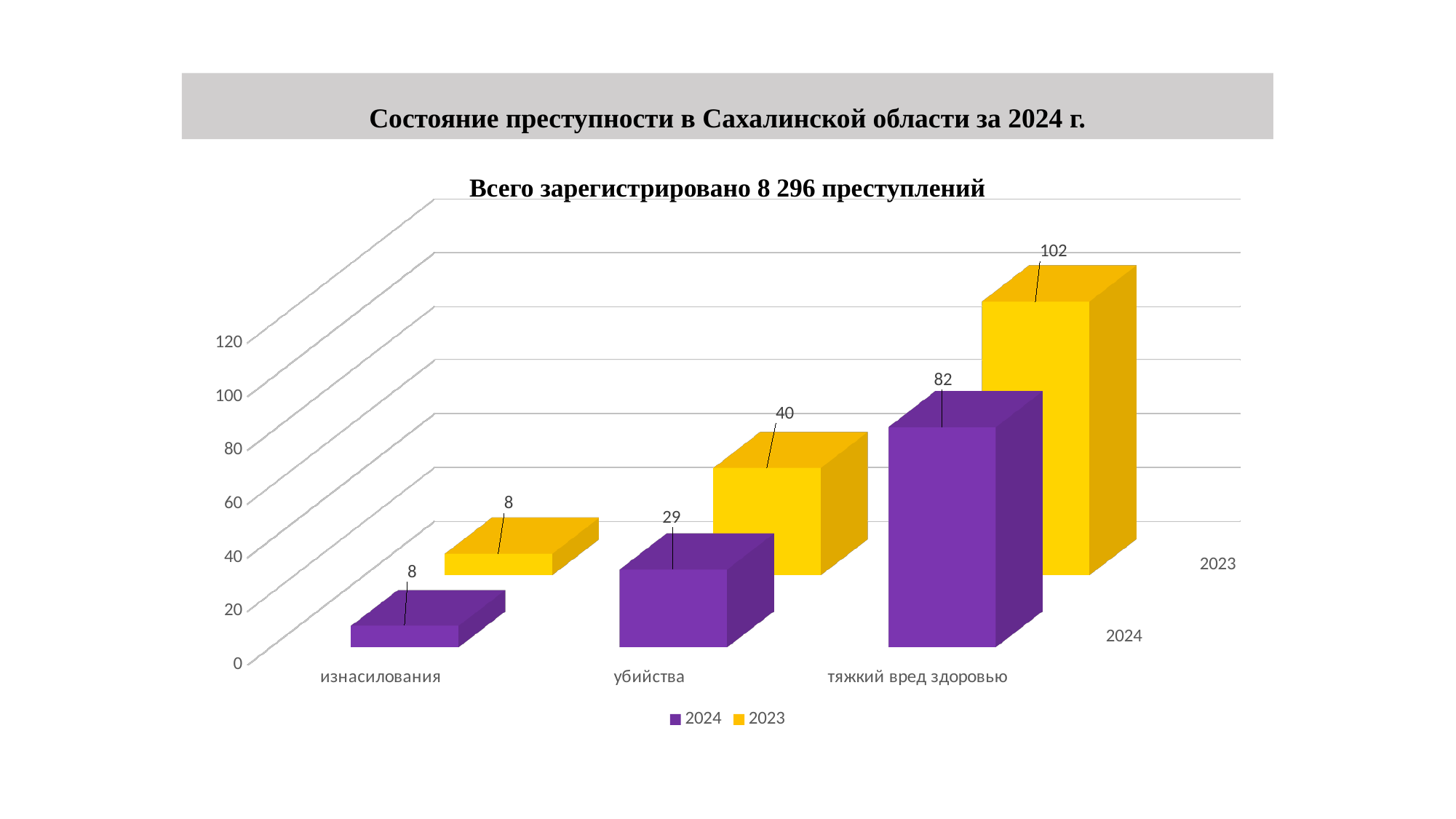
What is the value for тяжкий вред здоровью in the 2024 series? 82 How many categories are shown on the x axis? 3 Which category has the lowest value in the 2024 series? изнасилования How many series does the legend list? 2 What is the value for изнасилования in the 2023 series? 8 What is the value for убийства in the 2024 series? 29 Which category has the highest value in the 2023 series? тяжкий вред здоровью What is the value for тяжкий вред здоровью in the 2023 series? 102 Which is larger for убийства: the 2024 value or the 2023 value? 2023 What is the difference between the 2023 and 2024 values for тяжкий вред здоровью? 20 What is the difference between the 2023 and 2024 values for убийства? 11 What kind of chart is shown on the slide? bar chart